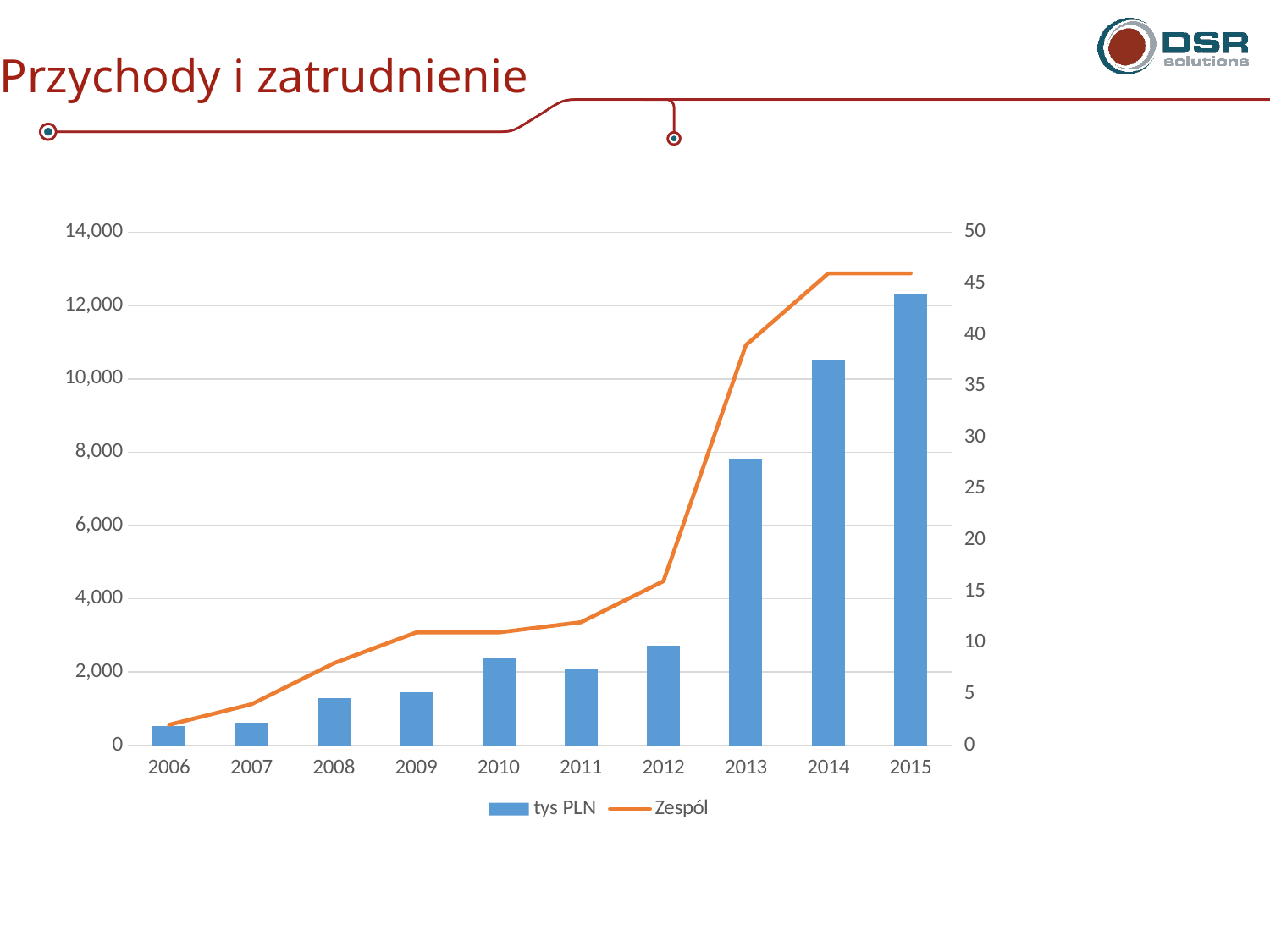
What kind of chart is shown on the slide? A combined bar and line chart Is the tys PLN bar for 2013 greater or less than 8,000? less How many series does the chart legend list? 2 Is the Zespól value for 2013 greater or less than 35? greater Is the Zespól value for 2006 greater or less than 5? less How many years are shown on the x axis of the chart? 10 What are the two series named in the chart legend? tys PLN and Zespól Which year has the larger tys PLN bar, 2010 or 2011? 2010 Do the Zespól values generally rise or fall from 2006 to 2015? rise Which year has the highest bar for tys PLN? 2015